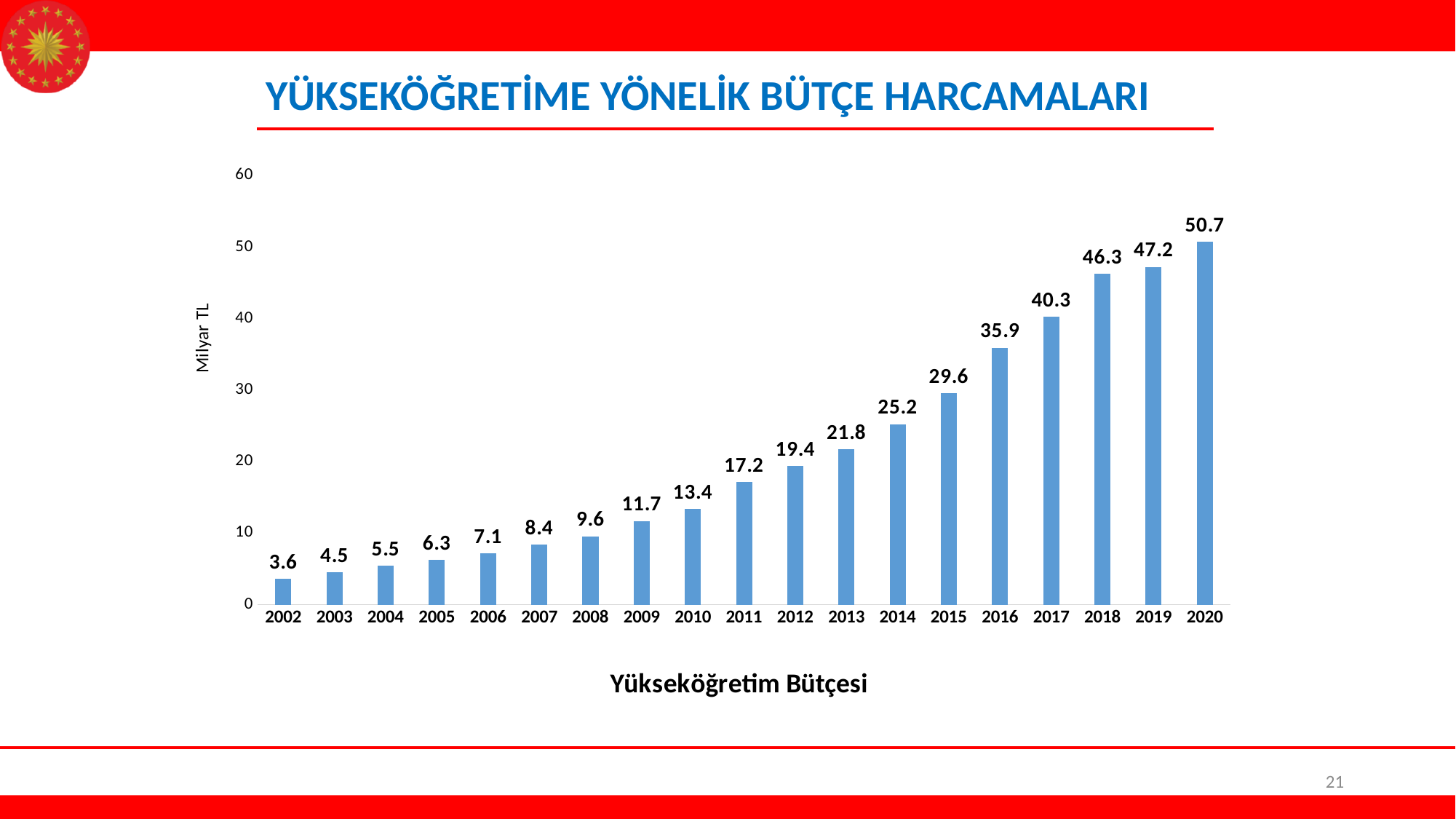
How many years are shown on the x axis? 19 What is the value for 2010? 13.4 Which is larger, the value for 2012 or the value for 2014? 2014 Is the value for 2018 greater or less than 40? greater Which year has the highest value? 2020 What is the value for 2017? 40.3 Do the values rise or fall from 2002 to 2020? rise What is the difference between the values for 2016 and 2015? 6.3 What kind of chart is shown on the slide? bar chart What is the value for 2002? 3.6 What is the difference between the values for 2020 and 2019? 3.5 Which year has the lowest value? 2002